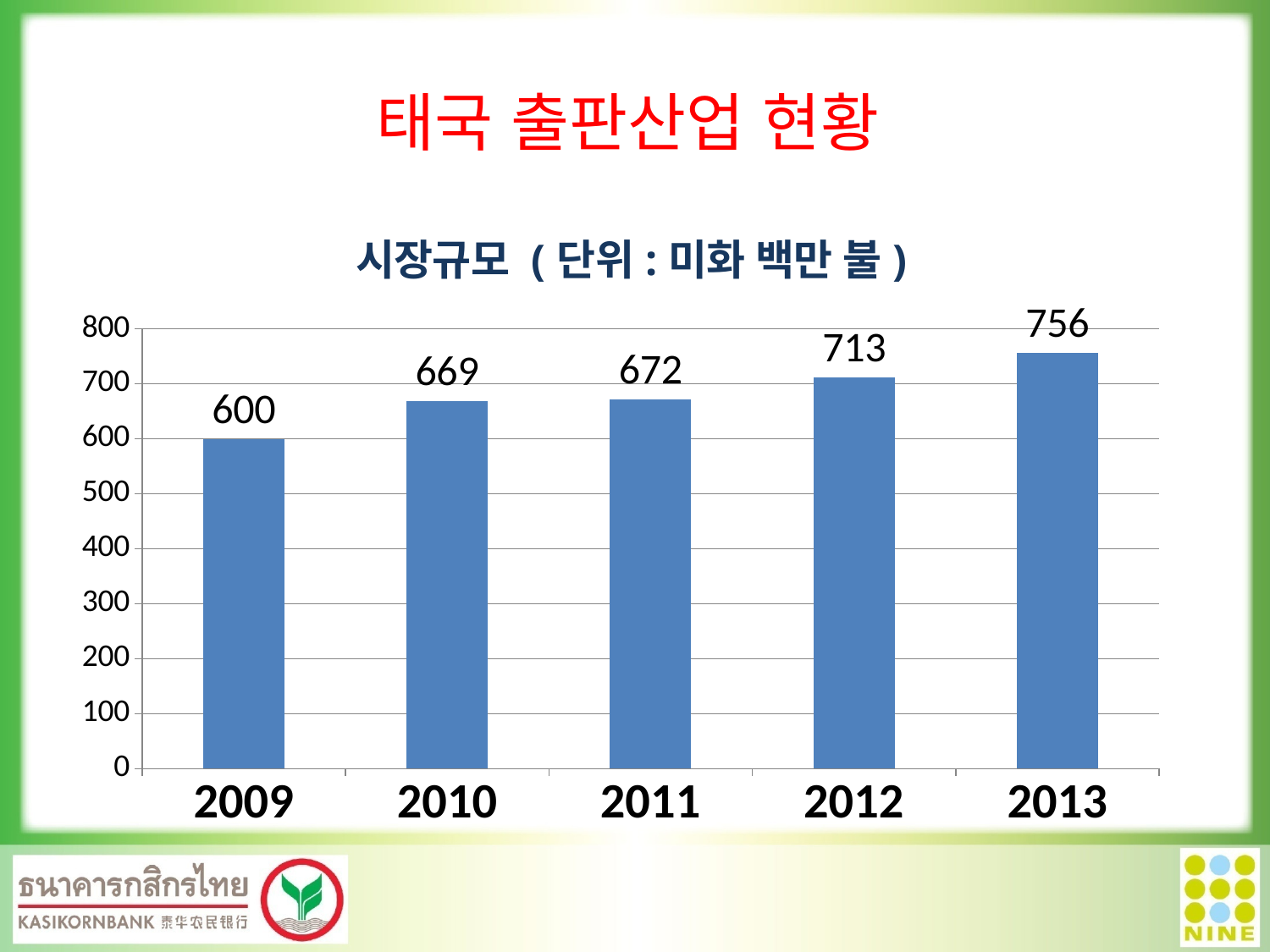
Which is larger, the value for 2012 or the value for 2010? 2012 Which year has the lowest market size? 2009 What is the market size value for 2013? 756 What is the difference between the 2013 value and the 2009 value? 156 What is the difference between the 2012 value and the 2010 value? 44 Do the values rise or fall from 2009 to 2013? rise Which year has the highest market size? 2013 What kind of chart is shown on the slide? bar chart Is the value for 2012 greater or less than 700? greater What is the market size value for 2011? 672 What is the market size value for 2009? 600 How many years are shown on the x axis? 5